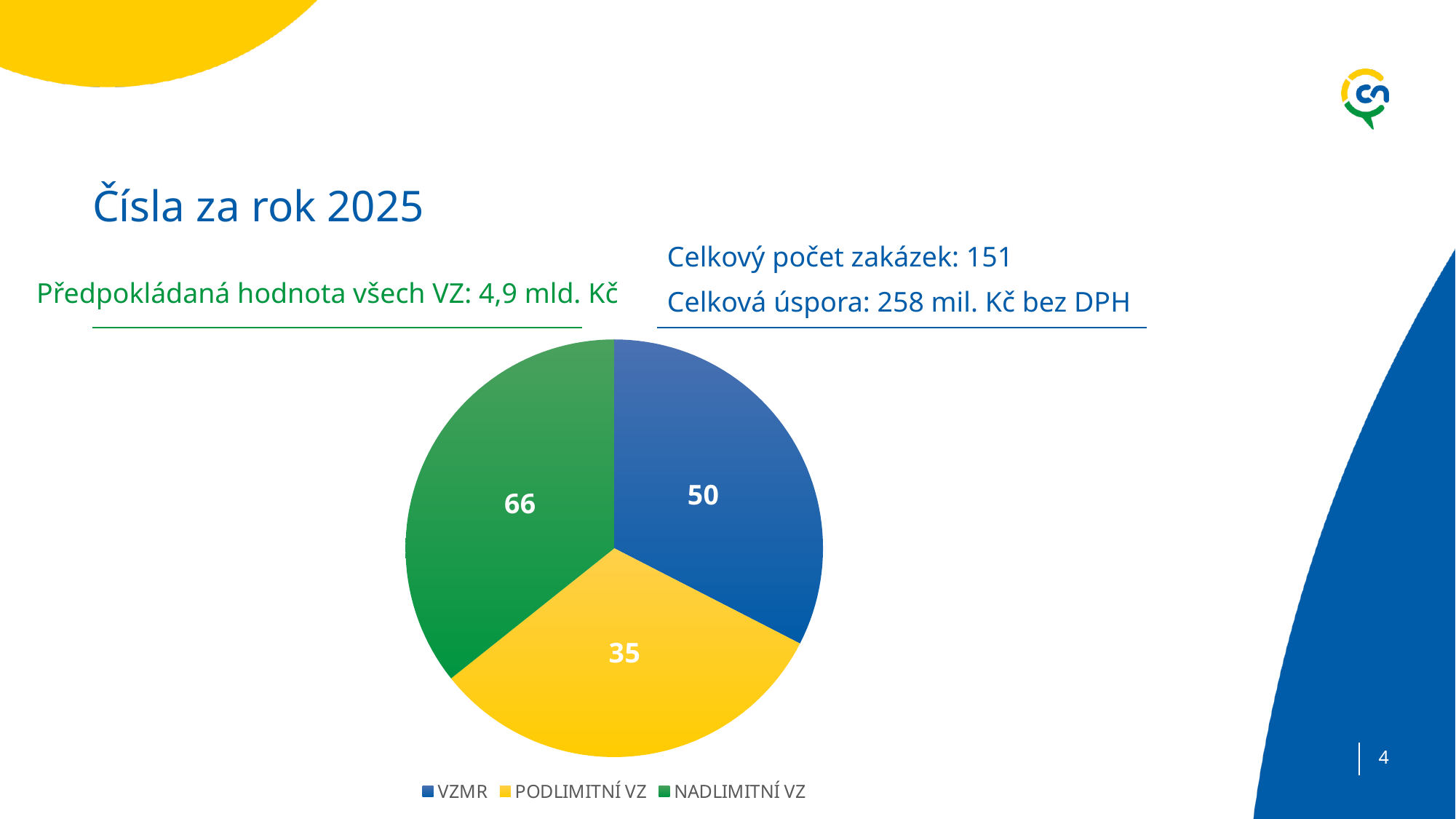
Which colour represents NADLIMITNÍ VZ in the pie chart? green What is the total of all slices in the pie chart? 151 What is the value for PODLIMITNÍ VZ in the pie chart? 35 Which category has the largest slice in the pie chart? NADLIMITNÍ VZ How many categories does the pie chart have? 3 What is the difference between the values for VZMR and PODLIMITNÍ VZ? 15 Which category has the smallest slice in the pie chart? PODLIMITNÍ VZ What is the difference between the values for NADLIMITNÍ VZ and VZMR? 16 What kind of chart is shown on the slide? pie chart What is the value for VZMR in the pie chart? 50 Which is larger, the value for VZMR or the value for PODLIMITNÍ VZ? VZMR What is the value for NADLIMITNÍ VZ in the pie chart? 66